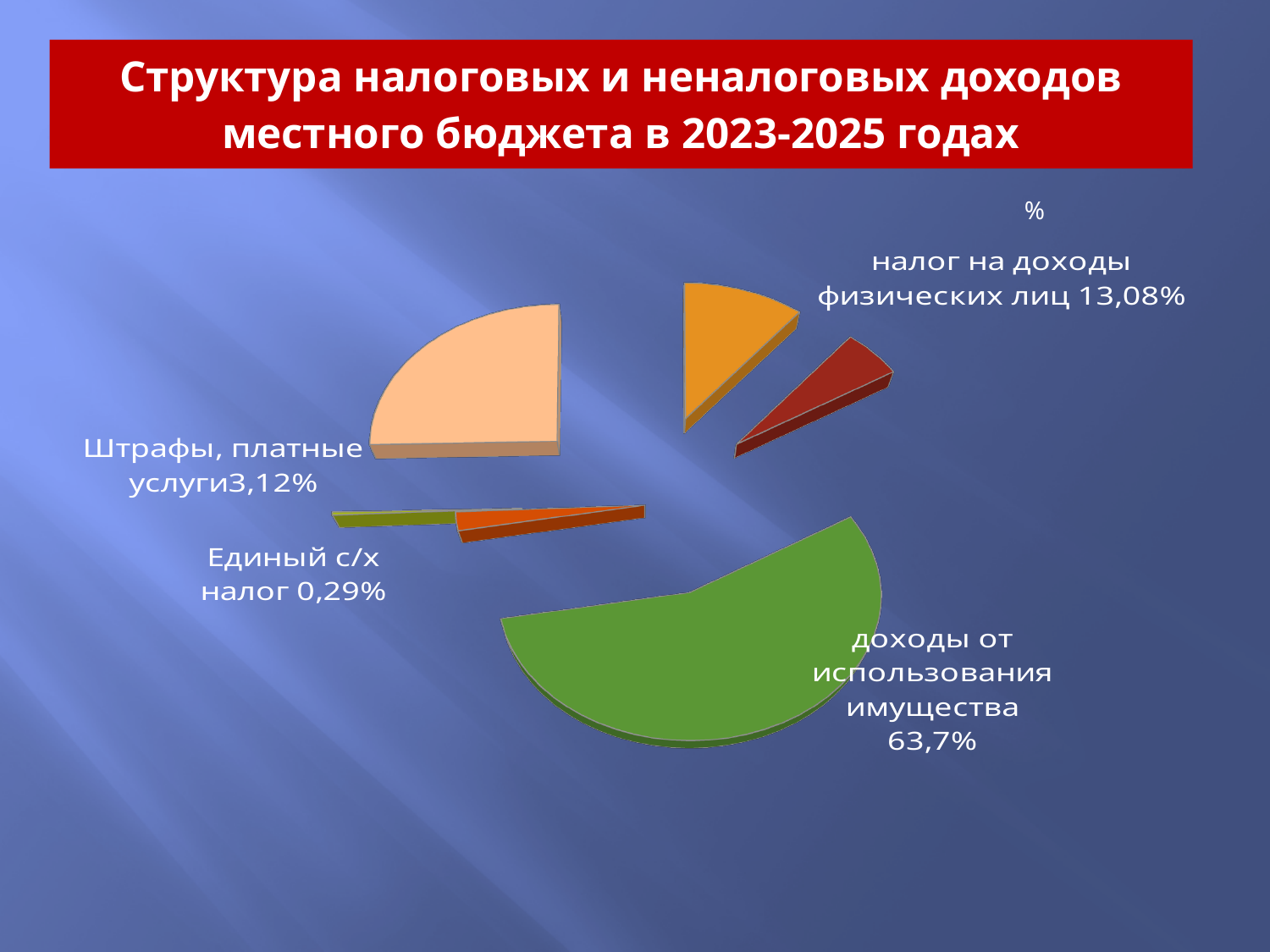
What value is shown for "Единый с/х налог"? 0,29% What share does "доходы от использования имущества" have in the pie chart? 63,7% What is the difference between the shares of "доходы от использования имущества" and "налог на доходы физических лиц"? 50,62% What colour is the largest slice of the pie chart? green What is the difference between the shares of "Штрафы, платные услуги" and "Единый с/х налог"? 2,83% How many slices does the pie chart have? 6 Which labelled category has the largest share of the pie? доходы от использования имущества What kind of chart is shown on the slide? pie chart What value is shown for "налог на доходы физических лиц"? 13,08% What value is shown for "Штрафы, платные услуги"? 3,12% Which labelled category has the smallest share of the pie? Единый с/х налог Which is larger: "налог на доходы физических лиц" or "Штрафы, платные услуги"? налог на доходы физических лиц